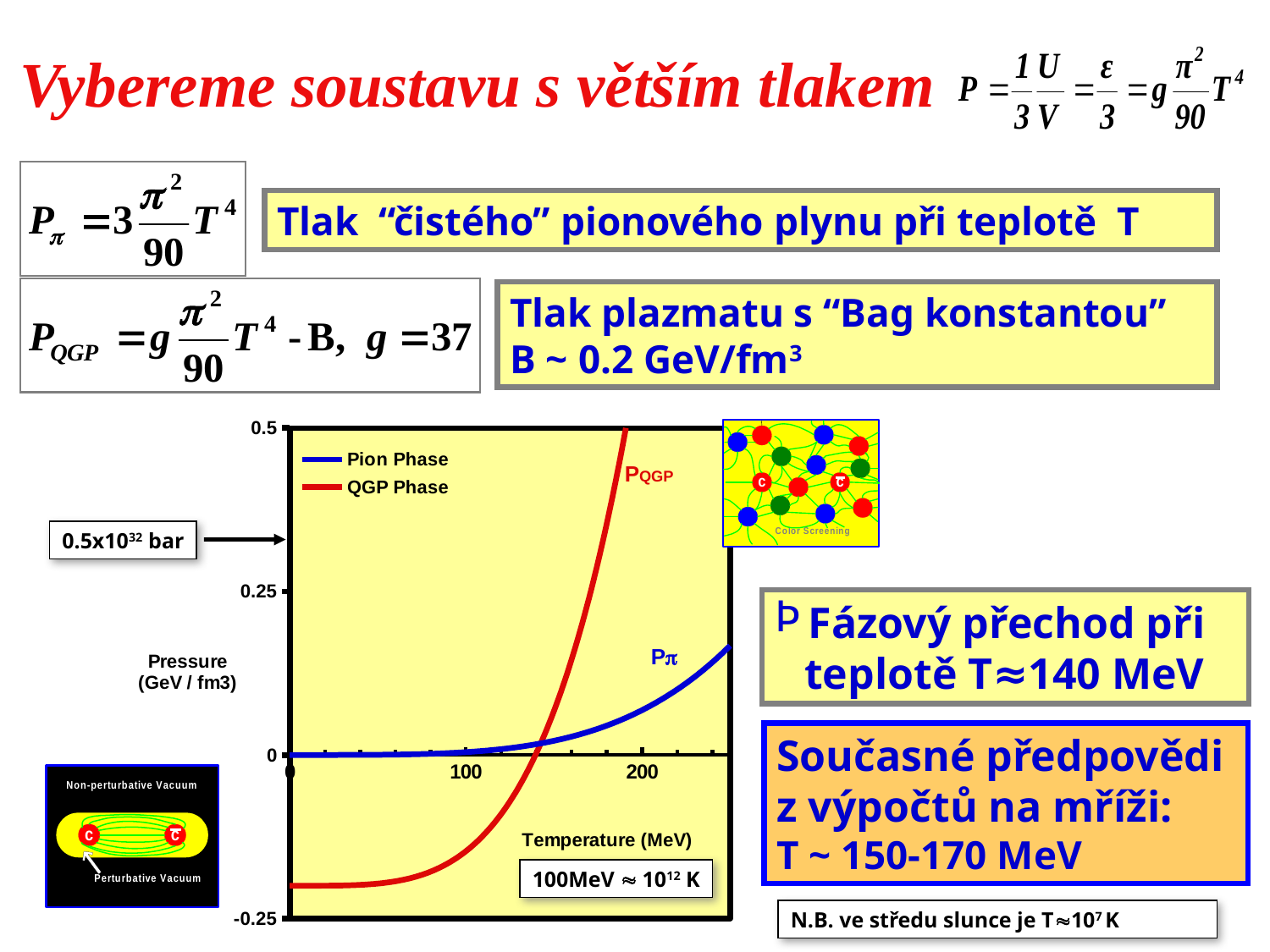
What is the highest value shown on the pressure (y) axis of the chart? 0.5 At a temperature of 200 MeV, which series has the higher pressure, Pion Phase or QGP Phase? QGP Phase Does the pressure of the Pion Phase rise or fall as temperature increases along the x axis? rise At a temperature of 100 MeV, is the QGP Phase pressure greater or less than 0? less Does the pressure of the QGP Phase rise or fall as temperature increases along the x axis? rise What colour is the QGP Phase line in the chart? red What are the two series named in the chart legend? Pion Phase and QGP Phase How many series does the chart legend list? 2 At a temperature of 200 MeV, is the Pion Phase pressure greater or less than 0.25? less What kind of chart is shown on the slide? line chart At a temperature of 200 MeV, is the QGP Phase pressure greater or less than 0.25? greater At a temperature of 100 MeV, which series has the higher pressure, Pion Phase or QGP Phase? Pion Phase